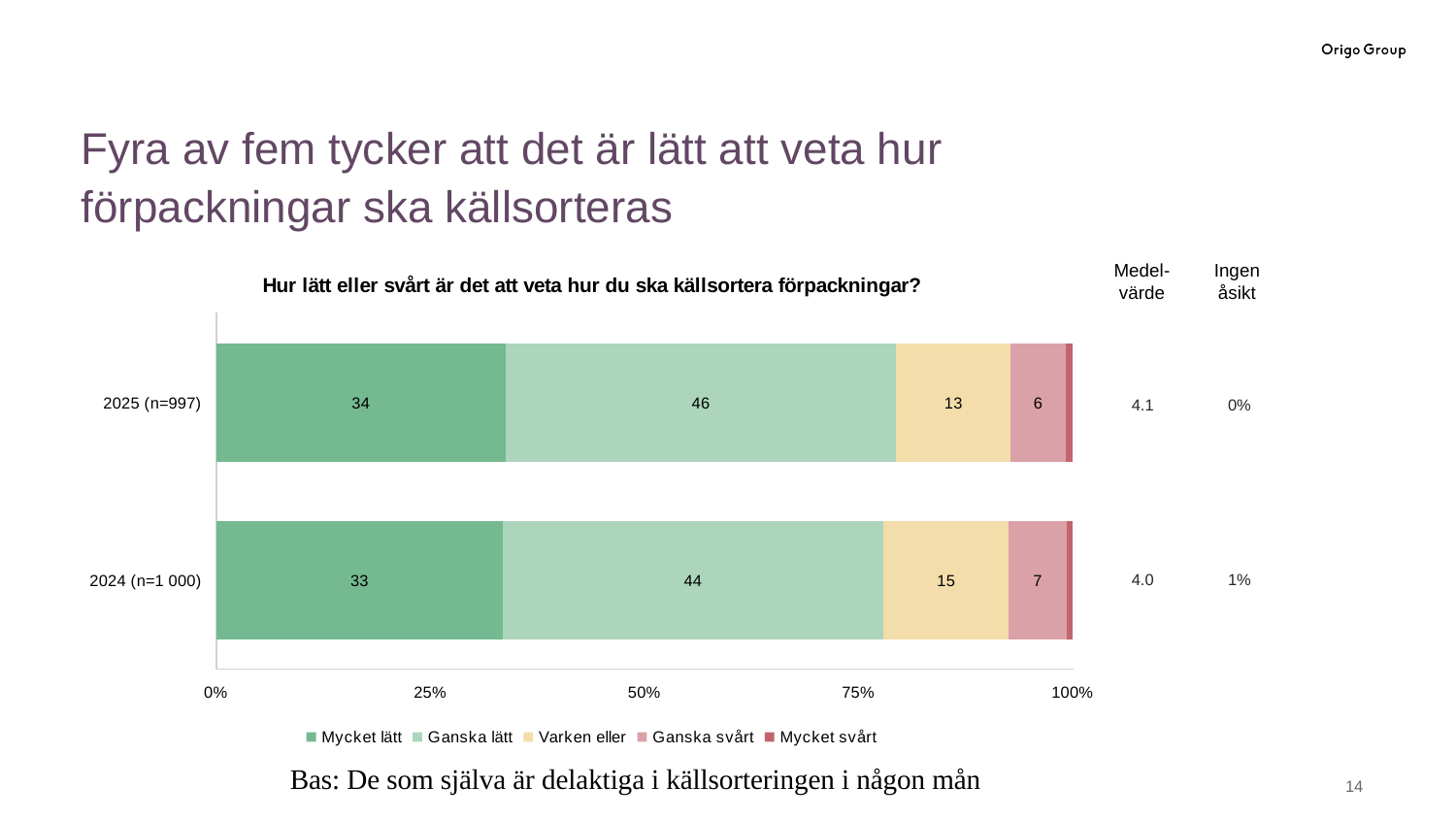
What kind of chart is shown on the slide? stacked bar chart What is the Medelvärde shown for 2025 (n=997)? 4.1 How many series does the legend list? 5 What is the value for Ganska svårt in 2024 (n=1 000)? 7 What is the title of the chart? Hur lätt eller svårt är det att veta hur du ska källsortera förpackningar? Which year has the larger Varken eller value, 2025 (n=997) or 2024 (n=1 000)? 2024 (n=1 000) What is the difference between the Ganska lätt values for 2025 (n=997) and 2024 (n=1 000)? 2 What is the value for Ganska lätt in 2024 (n=1 000)? 44 What is the Ingen åsikt value shown for 2024 (n=1 000)? 1% What is the value for Varken eller in 2025 (n=997)? 13 How many categories (years) are shown on the chart? 2 What is the value for Mycket lätt in 2025 (n=997)? 34